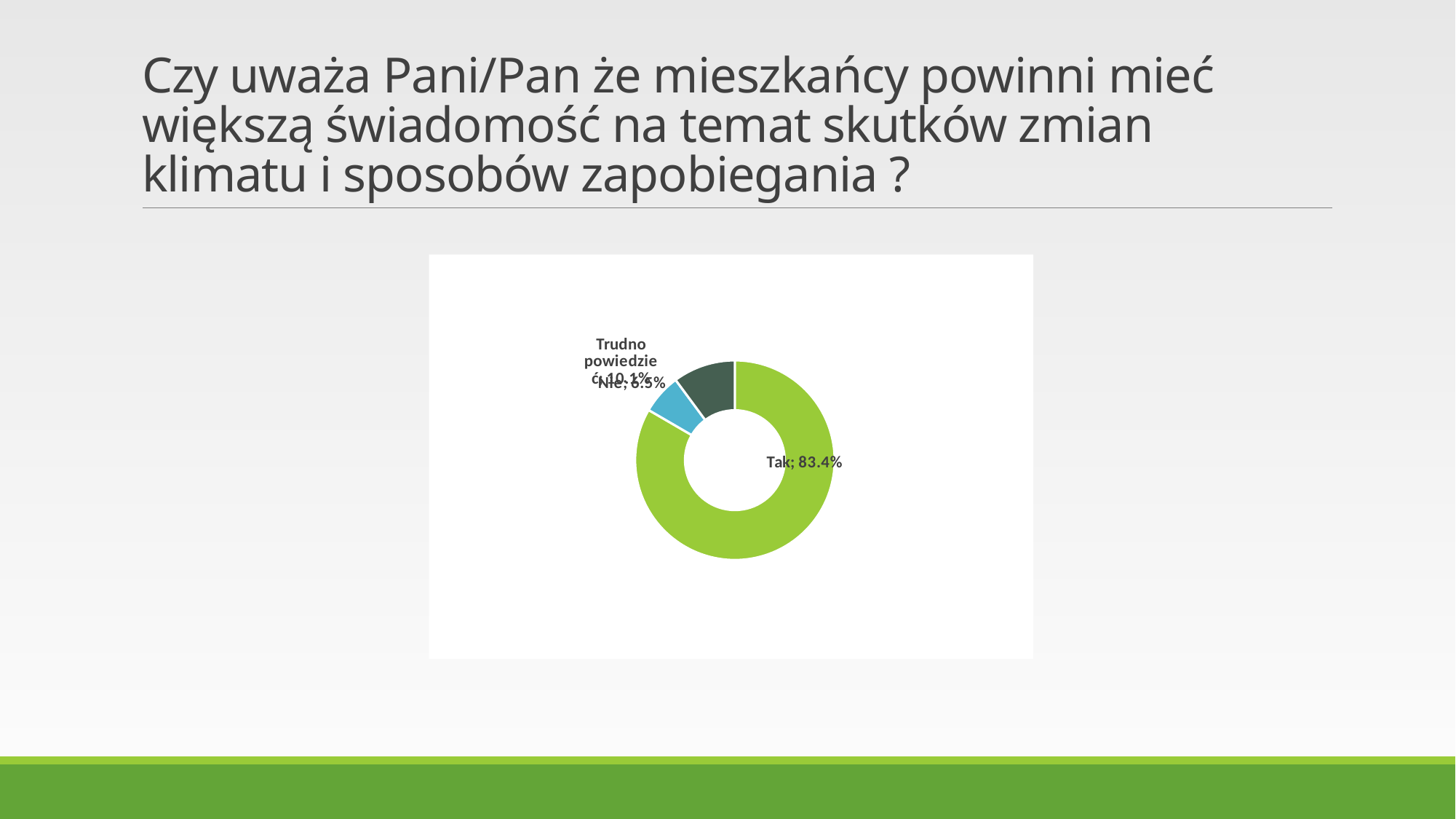
How many response categories are shown in the chart? 3 What colour is the "Tak" slice of the chart? Green What share of the chart does the "Tak" slice represent? 83.4% Which response category has the smallest slice in the chart? Nie What colour is the "Nie" slice of the chart? Blue Which slice is larger, "Trudno powiedzieć" or "Nie"? Trudno powiedzieć Which response category has the largest share of the doughnut chart? Tak Which slice is larger, "Tak" or "Nie"? Tak What kind of chart is shown on the slide? Doughnut (pie) chart What percentage of respondents answered "Tak"? 83.4%